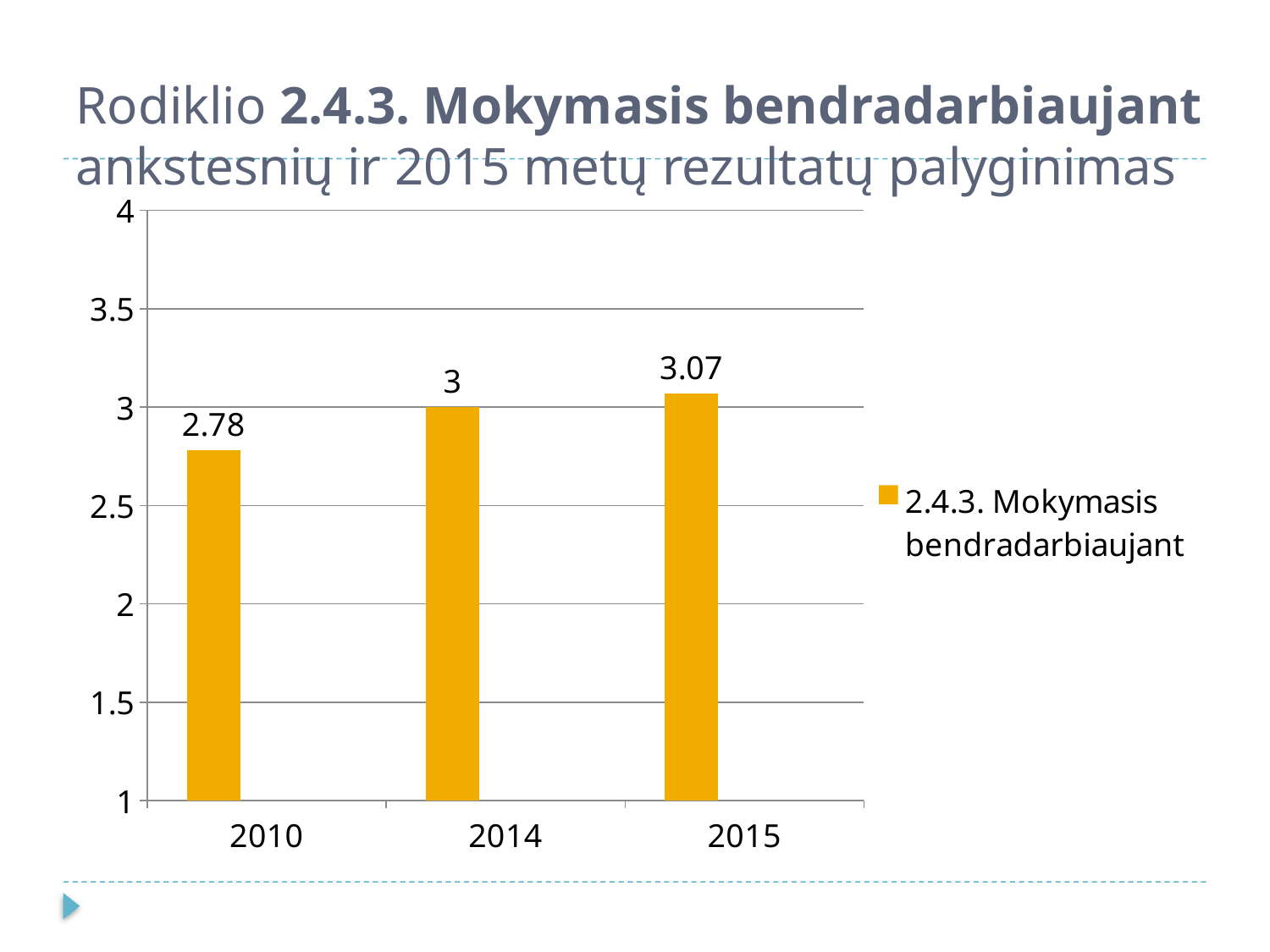
What is the value for 2015? 3.07 What is the difference between the values for 2014 and 2010? 0.22 Which year has the lowest value? 2010 What is the value for 2010? 2.78 How many years are shown on the x axis? 3 Which year has the highest value? 2015 Which is larger, the value for 2010 or the value for 2014? 2014 What kind of chart is shown on the slide? bar chart What is the value for 2014? 3 Do the values rise or fall from 2010 to 2015? rise What is the difference between the values for 2015 and 2010? 0.29 Is the value for 2010 greater or less than 3? less